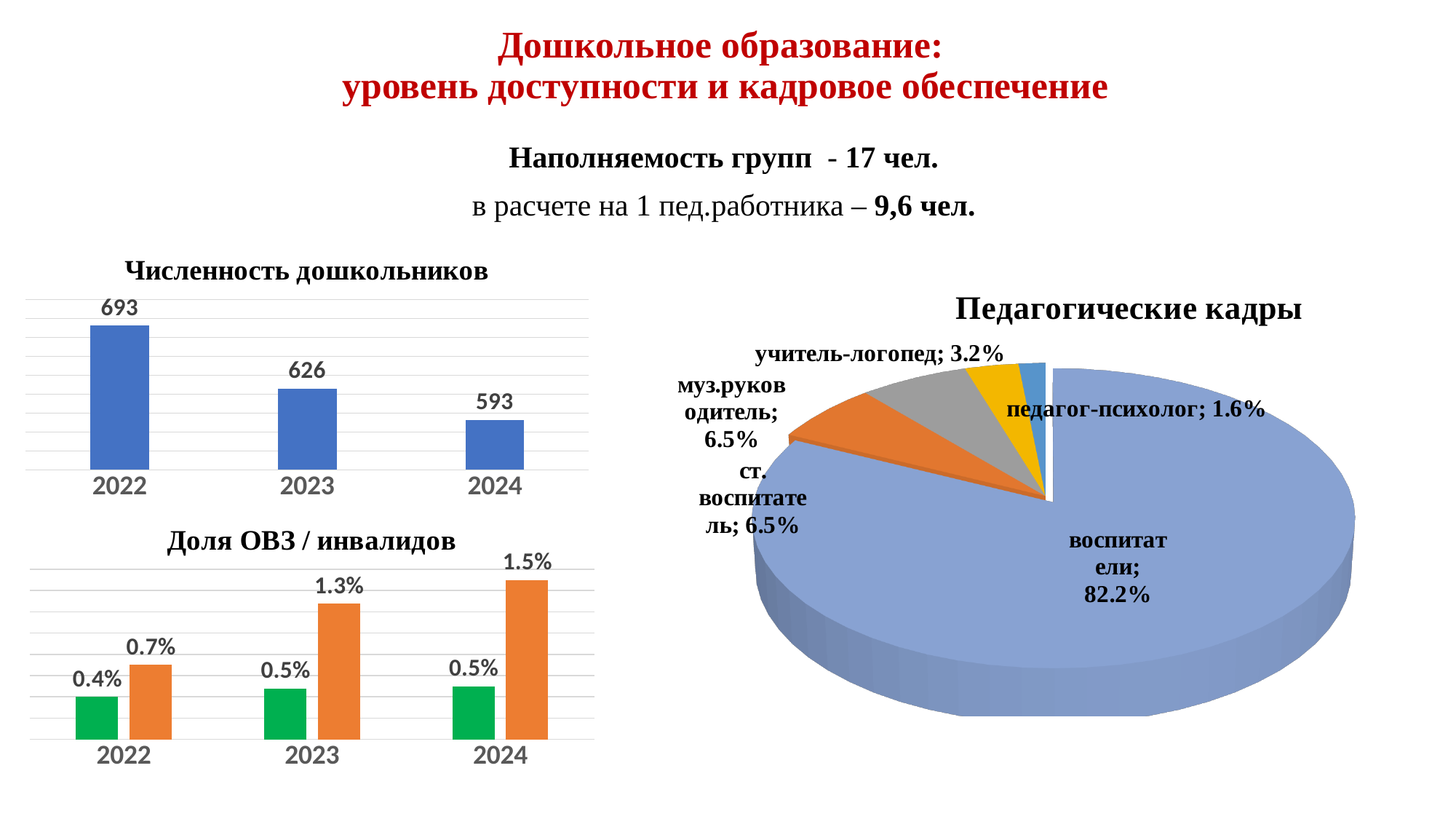
In the chart "Численность дошкольников", what is the value for 2024? 593 In the chart "Доля ОВЗ / инвалидов", which is larger for 2023: the green bar or the orange bar? the orange bar In the chart "Численность дошкольников", do the values rise or fall from 2022 to 2024? fall In the chart "Педагогические кадры", which category has the smallest slice? педагог-психолог In the chart "Численность дошкольников", which year has the lowest value? 2024 In the chart "Педагогические кадры", what share of the pie is "воспитатели"? 82.2% In the chart "Доля ОВЗ / инвалидов", what is the difference between the orange bar and the green bar for 2023? 0.8% In the chart "Численность дошкольников", what is the value for 2022? 693 In the chart "Численность дошкольников", how many years are shown on the x axis? 3 In the chart "Доля ОВЗ / инвалидов", what is the value of the orange bar for 2024? 1.5% In the chart "Доля ОВЗ / инвалидов", what is the value of the green bar for 2022? 0.4% In the chart "Численность дошкольников", what is the difference between the values for 2022 and 2023? 67